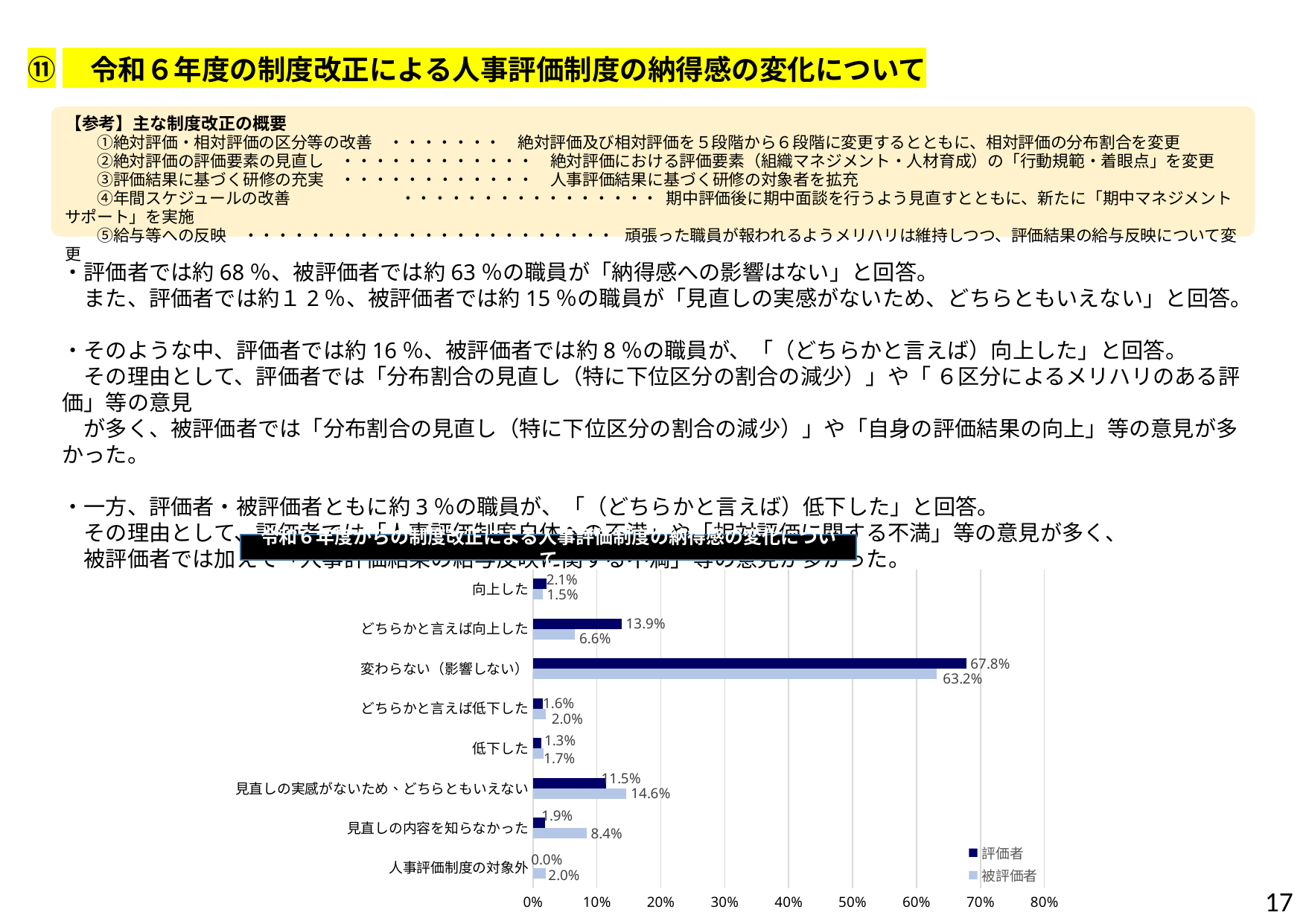
What is the value for 評価者 in the category 変わらない（影響しない）? 67.8% What is the difference between the 評価者 and 被評価者 values for 変わらない（影響しない）? 4.6% What is the value for 被評価者 in the category 見直しの内容を知らなかった? 8.4% How many categories are plotted in the chart? 8 Which series is shown in dark navy in the chart legend? 評価者 For 見直しの実感がないため、どちらともいえない, which series has the larger value, 評価者 or 被評価者? 被評価者 How many series does the chart legend list? 2 What kind of chart is shown on the slide? bar chart Which category has the lowest value for 評価者? 人事評価制度の対象外 Which category has the highest value for 評価者? 変わらない（影響しない） Is the value for 評価者 in どちらかと言えば向上した greater or less than 10%? greater What is the value for 被評価者 in the category どちらかと言えば向上した? 6.6%